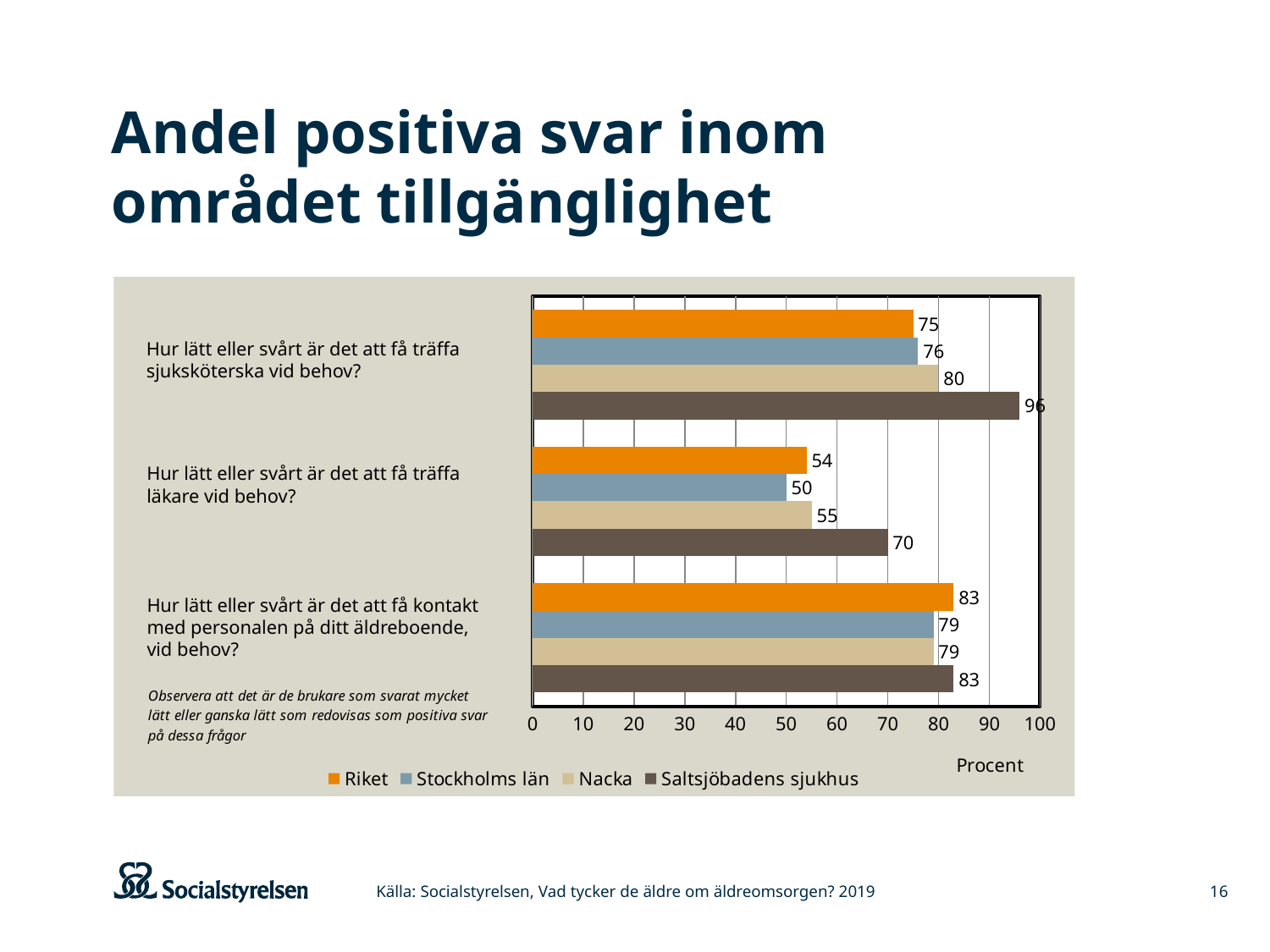
What kind of chart is shown on the slide? Bar chart How many question categories are shown on the chart? 3 Which series has the highest value on the question "Hur lätt eller svårt är det att få träffa läkare vid behov?"? Saltsjöbadens sjukhus What value is shown for Stockholms län on the question "Hur lätt eller svårt är det att få träffa läkare vid behov?"? 50 What value is shown for Saltsjöbadens sjukhus on the question "Hur lätt eller svårt är det att få träffa sjuksköterska vid behov?"? 96 What value is shown for Riket on the question "Hur lätt eller svårt är det att få kontakt med personalen på ditt äldreboende, vid behov?"? 83 Which is larger on the question "Hur lätt eller svårt är det att få träffa läkare vid behov?": the value for Riket or the value for Stockholms län? Riket What value is shown for Nacka on the question "Hur lätt eller svårt är det att få träffa läkare vid behov?"? 55 What is the label on the horizontal axis of the chart? Procent How many series does the legend list? 4 What is the difference between the Saltsjöbadens sjukhus value and the Riket value on the question "Hur lätt eller svårt är det att få träffa sjuksköterska vid behov?"? 21 Which series has the lowest value on the question "Hur lätt eller svårt är det att få träffa sjuksköterska vid behov?"? Riket